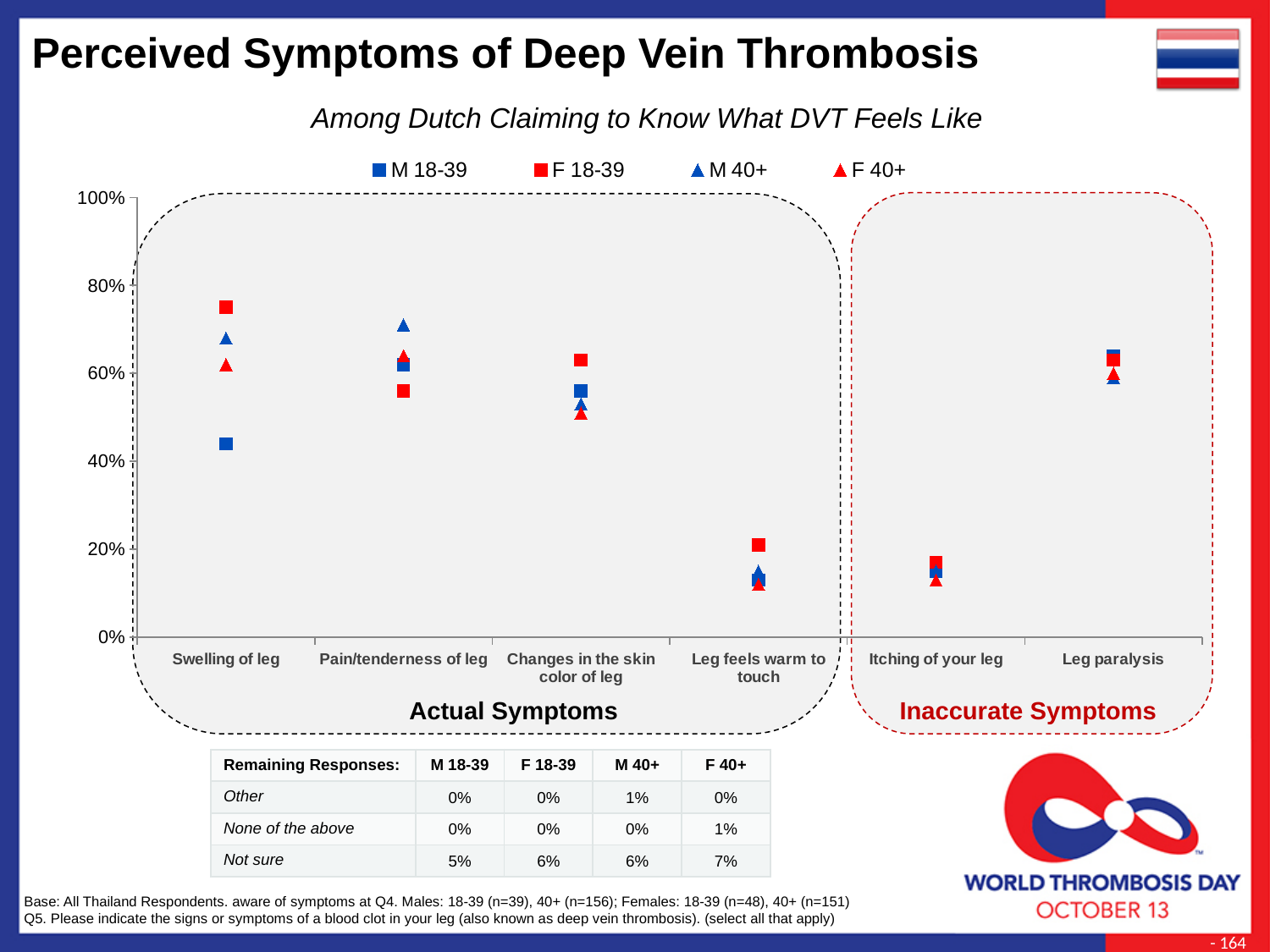
Which series has the highest value for 'Pain/tenderness of leg'? M 40+ Is the value for F 18-39 on 'Leg feels warm to touch' greater or less than 40%? less For 'Leg feels warm to touch', which is larger: the value for F 18-39 or the value for F 40+? F 18-39 Is the value for M 18-39 on 'Swelling of leg' greater or less than 60%? less Which symptoms are grouped under the label 'Inaccurate Symptoms'? Itching of your leg and Leg paralysis Which series has the highest value for 'Swelling of leg'? F 18-39 Which series has the lowest value for 'Swelling of leg'? M 18-39 How many series does the legend list? 4 Is the value for F 18-39 on 'Swelling of leg' greater or less than 60%? greater What kind of chart is shown on the slide? Scatter (dot) chart How many symptom categories are plotted along the x axis? 6